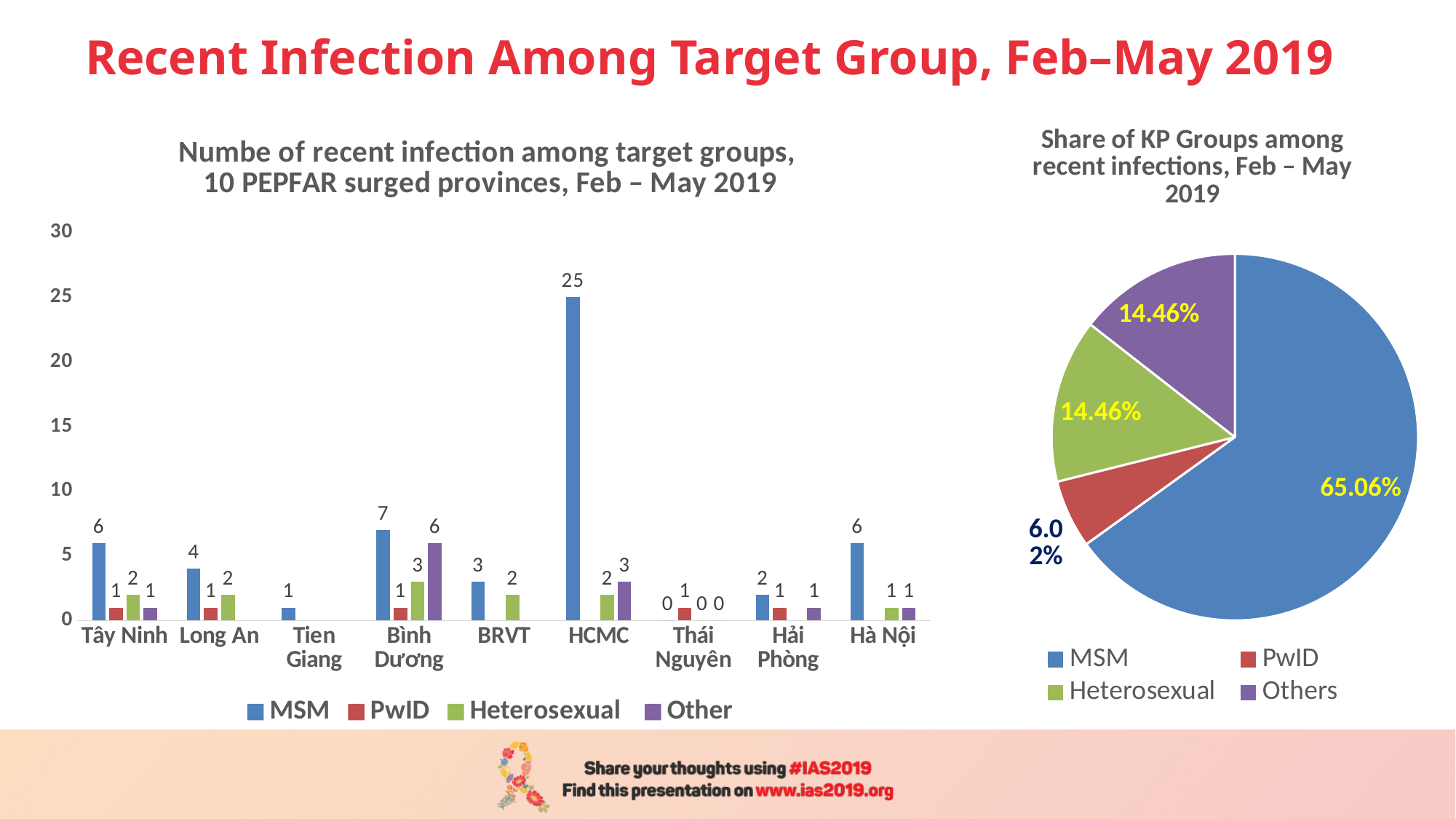
In the bar chart on the left, what is the Other value for Bình Dương? 6 In the bar chart on the left, which is larger: the MSM value for Tây Ninh or the MSM value for Long An? Tây Ninh In the bar chart on the left, how many provinces are shown on the x axis? 9 In the bar chart on the left, what is the difference between the MSM values for HCMC and Bình Dương? 18 What kind of chart is the chart on the left? Bar chart In the bar chart on the left, what is the MSM value for HCMC? 25 In the bar chart on the left, how many series does the legend list? 4 In the pie chart on the right, which group has the largest slice? MSM In the pie chart on the right, what share does MSM have? 65.06% What is the title of the pie chart on the right? Share of KP Groups among recent infections, Feb – May 2019 In the bar chart on the left, which province has the highest MSM value? HCMC In the pie chart on the right, what share does PwID have? 6.02%